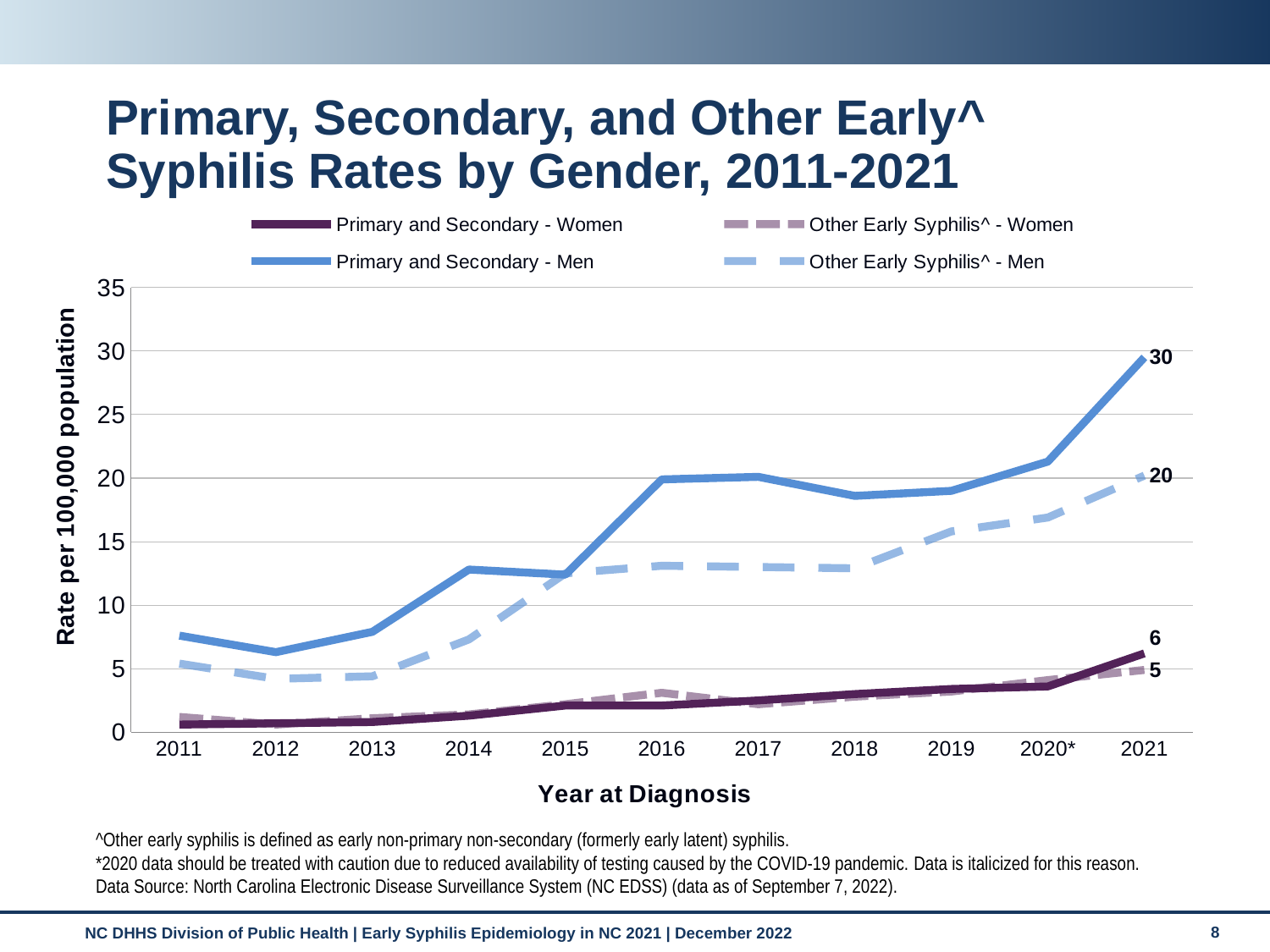
What is the 2021 rate for Other Early Syphilis^ - Men? 20 In 2021, which is larger: the Primary and Secondary - Women rate or the Other Early Syphilis^ - Women rate? Primary and Secondary - Women What is the 2021 rate for Primary and Secondary - Women? 6 What is the 2021 rate for Other Early Syphilis^ - Women? 5 How many years are shown on the x axis? 11 How many series does the legend list? 4 What is the 2021 rate for Primary and Secondary - Men? 30 Does the Primary and Secondary - Men rate rise or fall from 2018 to 2021? rise Is the 2011 value for Primary and Secondary - Men greater or less than 10? less Which series has the highest rate in 2021? Primary and Secondary - Men What kind of chart is shown on the slide? Line chart In 2021, what is the difference between the Primary and Secondary - Men rate and the Other Early Syphilis^ - Men rate? 10